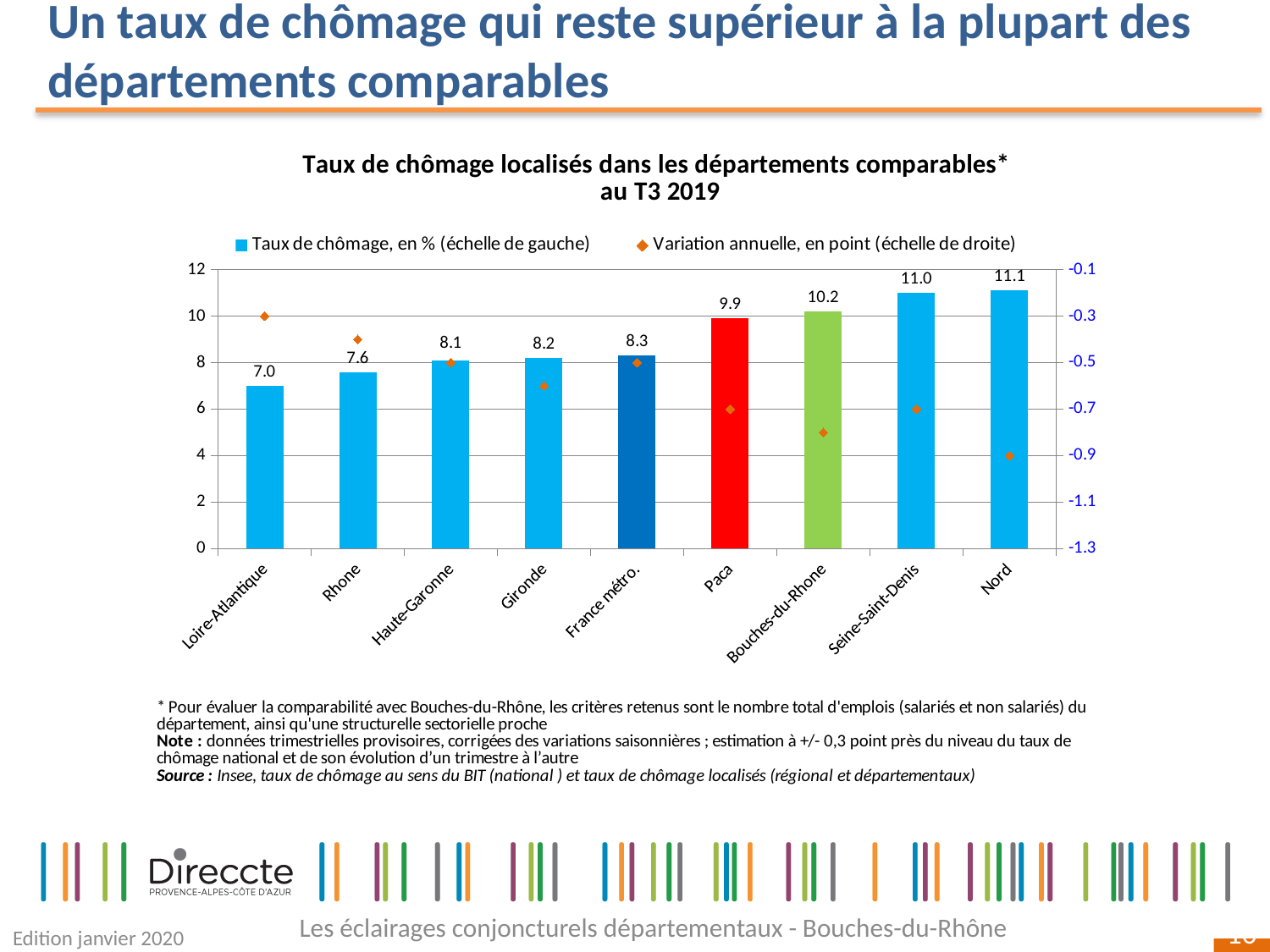
What is the difference between the unemployment rate of Bouches-du-Rhone and that of France métro.? 1.9 What is the unemployment rate shown for France métro.? 8.3 What is the unemployment rate shown for Paca? 9.9 Which has a higher unemployment rate, Seine-Saint-Denis or Paca? Seine-Saint-Denis How many departments or areas are shown on the x axis of the chart? 9 What is the unemployment rate (Taux de chômage) shown for Bouches-du-Rhone? 10.2 Which department has the lowest unemployment rate on the chart? Loire-Atlantique Do the unemployment rate bars rise or fall from left to right along the x axis? rise Is the annual variation for Loire-Atlantique greater or less than -0.5 on the right-hand axis? greater Is the annual variation (Variation annuelle) for Nord greater or less than -0.7 on the right-hand axis? less How many series does the chart legend list? 2 Which department has the highest unemployment rate on the chart? Nord